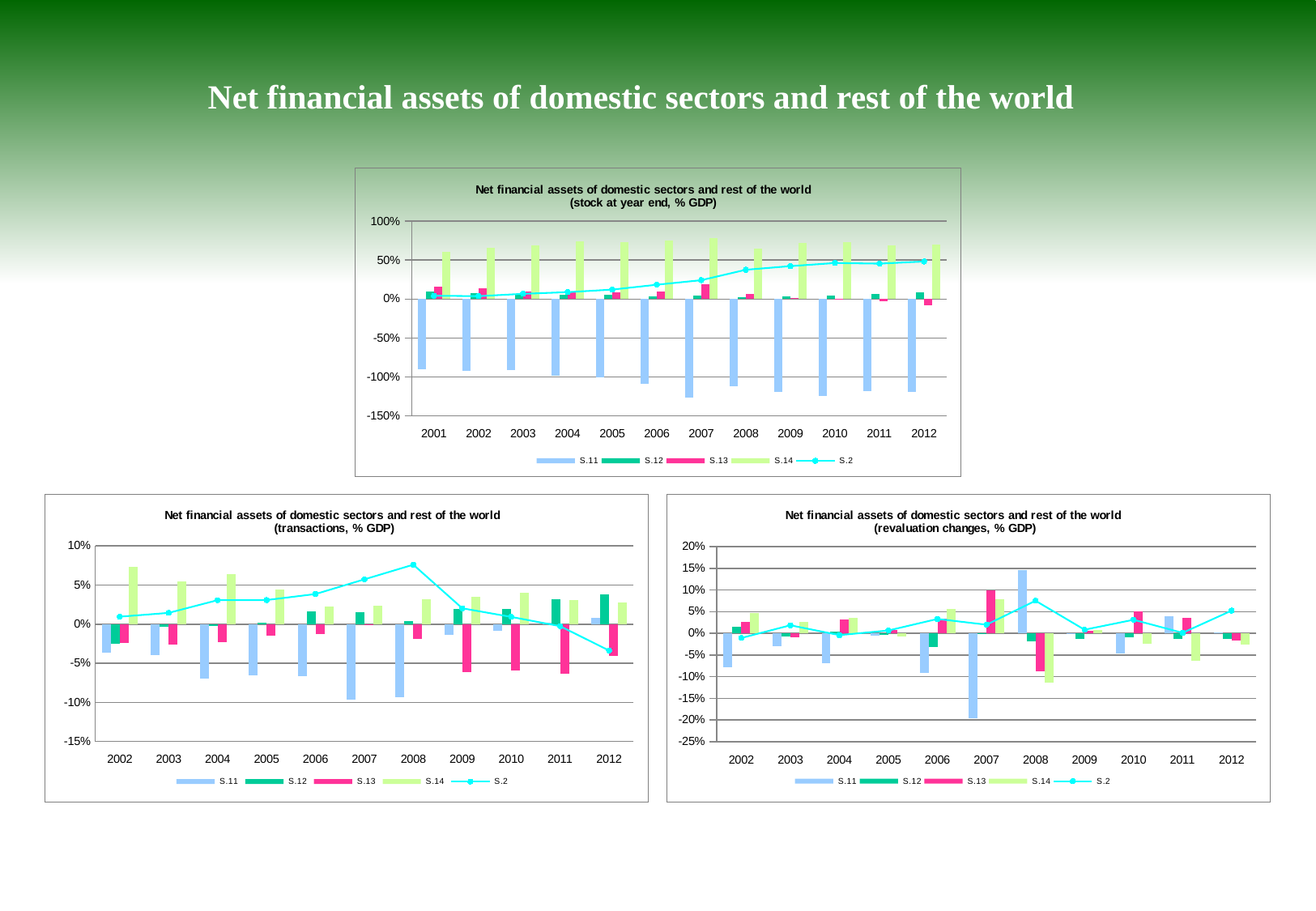
In the bottom-right chart (revaluation changes, % GDP), is the S.11 value for 2008 greater or less than 10%? greater In the top chart (stock at year end, % GDP), is the S.11 value for 2007 greater or less than -100%? less In the bottom-left chart (transactions, % GDP), how many years are shown on the x axis? 11 In the bottom-right chart (revaluation changes, % GDP), in which year is the S.11 bar lowest? 2007 In the top chart (stock at year end, % GDP), does the S.2 line generally rise or fall from 2001 to 2012? rise In the bottom-left chart (transactions, % GDP), in which year does the S.2 line reach its highest point? 2008 In the top chart (stock at year end, % GDP), how many years are shown on the x axis? 12 In the bottom-left chart (transactions, % GDP), is the S.11 value for 2007 greater or less than -5%? less In the top chart (stock at year end, % GDP), which series is plotted as a line rather than bars? S.2 In the top chart (stock at year end, % GDP), how many series does the legend list? 5 What kind of chart is the bottom-right chart (revaluation changes, % GDP)? Combined bar and line chart